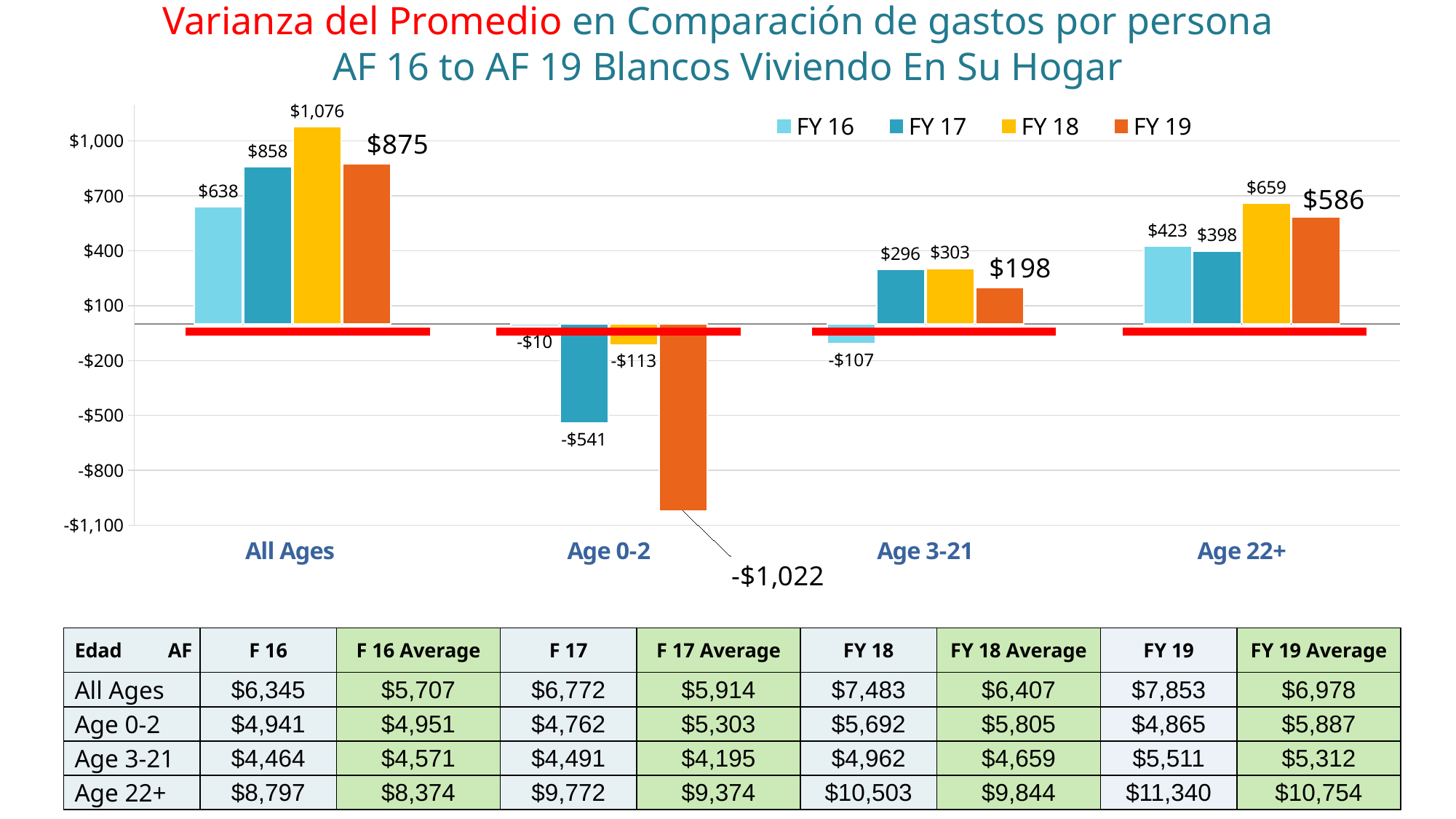
What is the FY 19 value for Age 0-2? -$1,022 What is the FY 17 value for Age 22+? $398 How many age categories are shown on the x axis of the chart? 4 What type of chart is shown on the slide? Bar chart What is the FY 16 value for Age 3-21? -$107 Which colour represents FY 18 in the chart legend? Yellow How many series does the chart legend list? 4 Which is larger for Age 22+: the FY 18 value or the FY 19 value? FY 18 What is the difference between the FY 18 and FY 16 values for All Ages? $438 Which age category has the lowest FY 17 value? Age 0-2 What is the FY 18 value for All Ages? $1,076 Which age category has the highest FY 19 value? All Ages